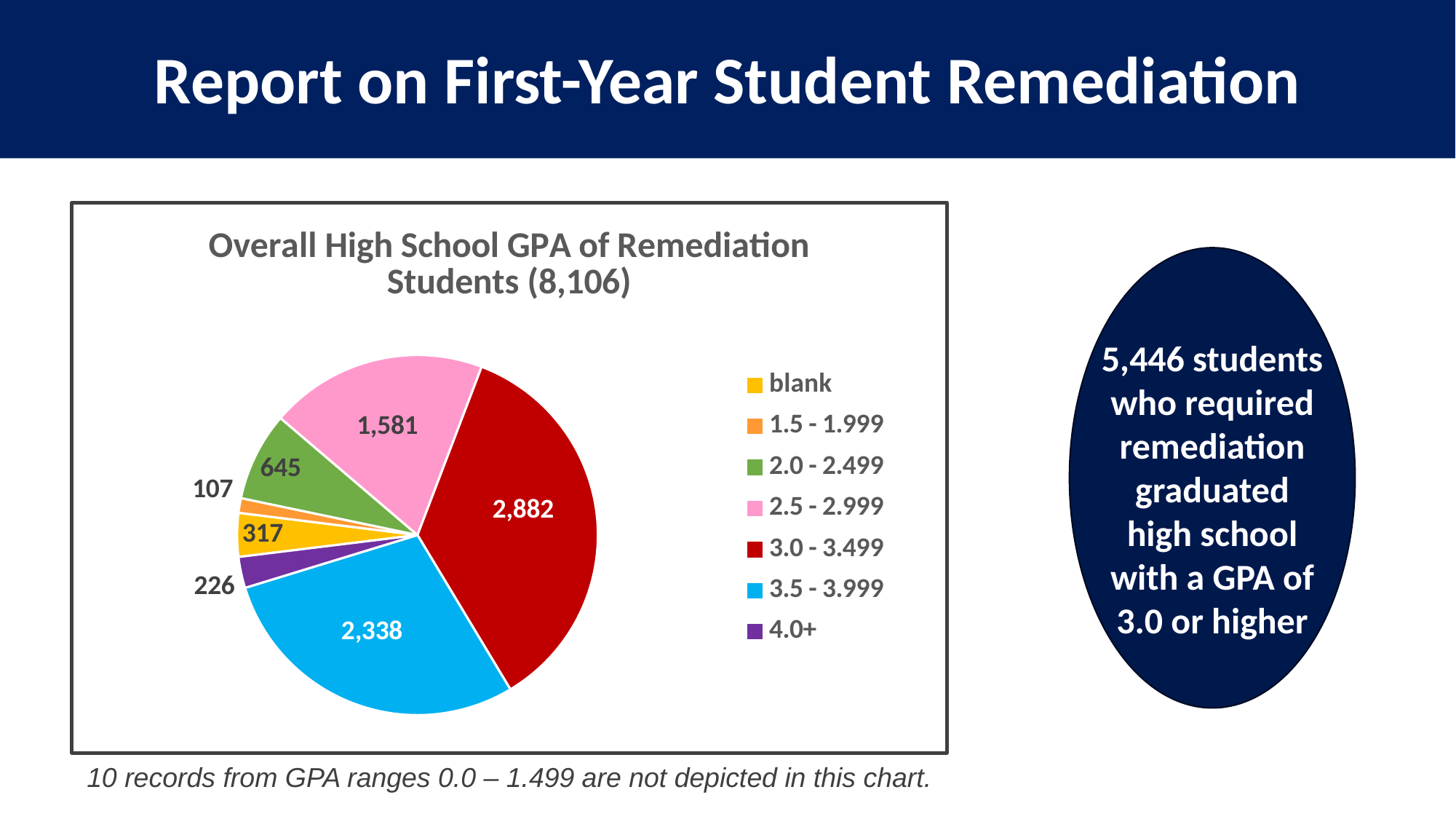
Which is larger, the 2.5 - 2.999 slice or the 2.0 - 2.499 slice? 2.5 - 2.999 What type of chart is shown on the slide? pie chart What is the value for the 2.0 - 2.499 GPA range? 645 How many students with a high school GPA of 3.0 - 3.499 are shown in the pie chart? 2,882 What is the title of the pie chart? Overall High School GPA of Remediation Students (8,106) How many categories does the pie chart legend list? 7 What is the value for the 3.5 - 3.999 GPA range in the pie chart? 2,338 What is the combined value of the 3.0 - 3.499, 3.5 - 3.999 and 4.0+ slices? 5,446 Which GPA range has the smallest slice of the pie chart? 1.5 - 1.999 What is the difference between the 3.0 - 3.499 and 3.5 - 3.999 values? 544 Which GPA range has the largest slice of the pie chart? 3.0 - 3.499 How many records are in the 'blank' GPA category? 317